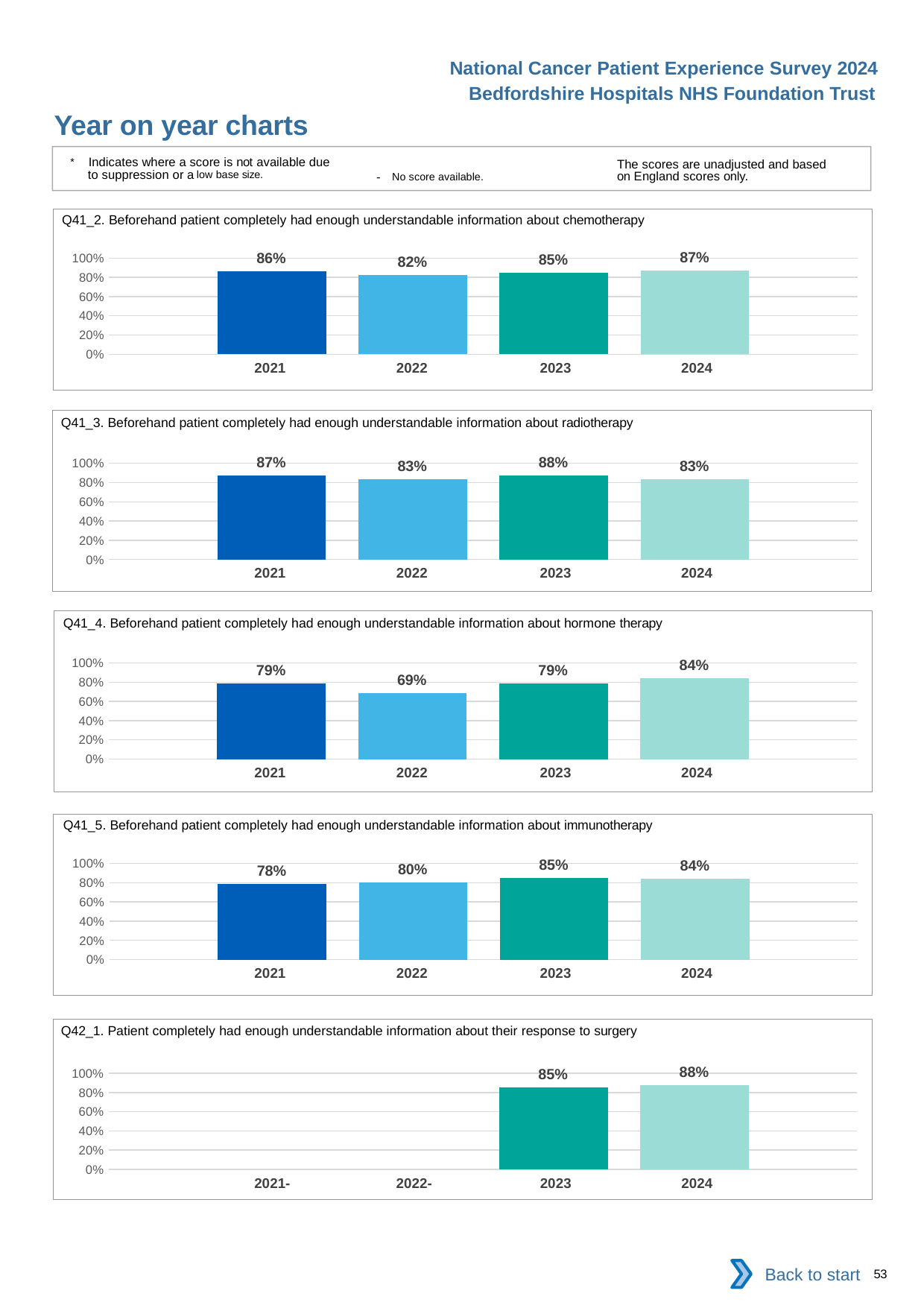
In the Q41_5 immunotherapy chart, what is the value for 2021? 78% In the Q42_1 surgery chart, what is the value for 2024? 88% In the Q41_4 hormone therapy chart, what is the difference between the 2021 and 2022 values? 10% In the Q42_1 surgery chart, how many years have a bar plotted? 2 In the Q41_5 immunotherapy chart, which is larger, the value for 2021 or the value for 2023? 2023 In the Q41_4 hormone therapy chart, which year has the highest value? 2024 In the Q41_2 chemotherapy chart, which year has the lowest value? 2022 What type of chart is the Q41_2 chemotherapy chart? Bar chart In the Q41_4 hormone therapy chart, what is the value for 2022? 69% In the Q41_2 chemotherapy chart, what is the value for 2024? 87% In the Q41_3 radiotherapy chart, what is the difference between the 2023 and 2024 values? 5% In the Q41_3 radiotherapy chart, what is the value for 2023? 88%